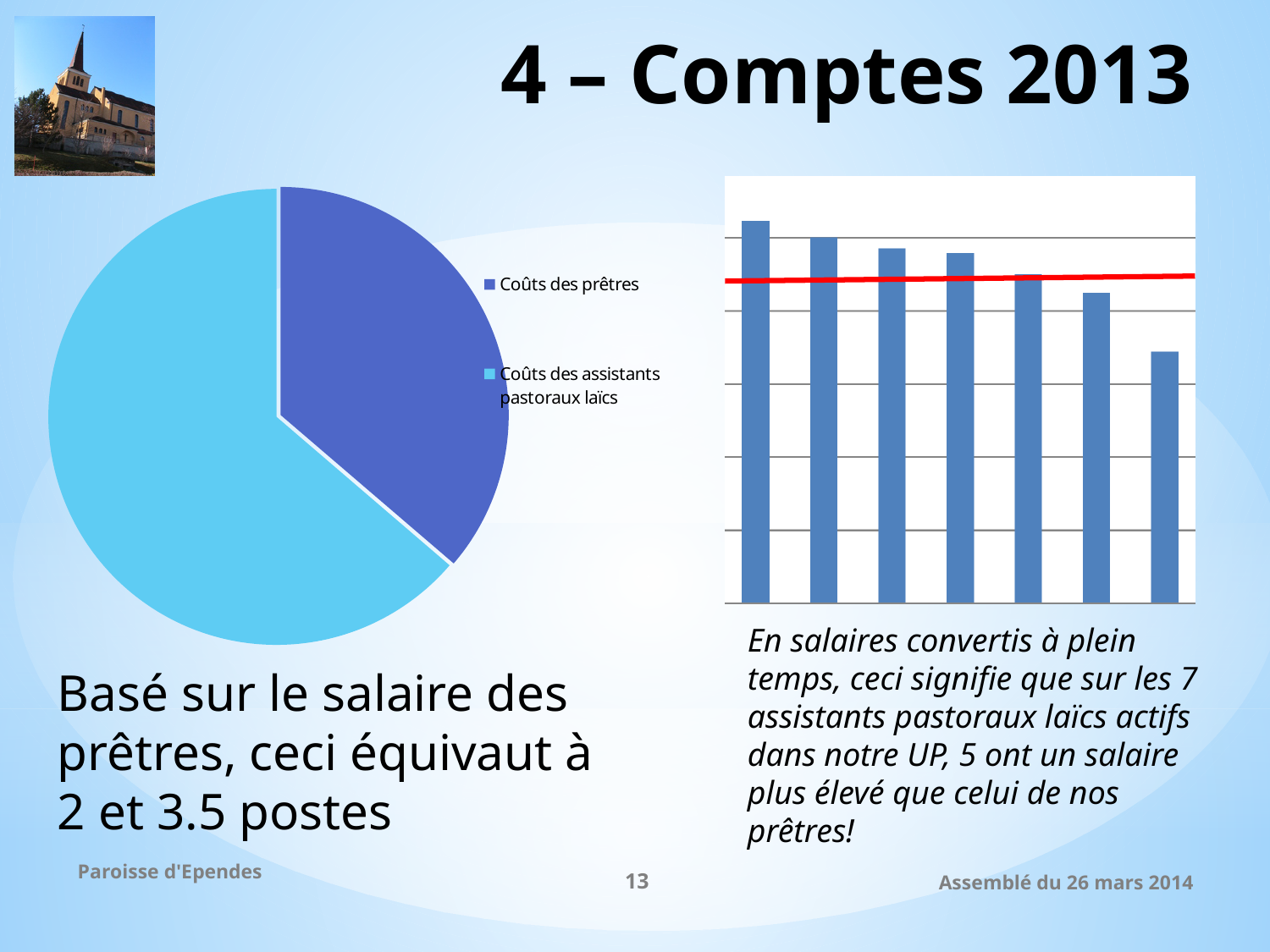
What kind of chart is the chart on the left of the slide? pie chart In the pie chart on the left, how many entries does the legend list? 2 In the bar chart on the right, which bar is the tallest? the first (leftmost) bar In the bar chart on the right, which bar is the shortest? the last (rightmost) bar In the pie chart on the left, which slice is larger: 'Coûts des prêtres' or 'Coûts des assistants pastoraux laïcs'? Coûts des assistants pastoraux laïcs In the bar chart on the right, do the bar values rise or fall from left to right? fall In the pie chart on the left, which category has the smallest slice? Coûts des prêtres What kind of chart is the chart on the right of the slide? bar chart In the bar chart on the right, how many bars rise above the red horizontal line? 5 In the pie chart on the left, what colour is the slice for 'Coûts des prêtres'? dark blue In the bar chart on the right, how many bars are plotted? 7 In the bar chart on the right, which is taller: the second bar or the sixth bar? the second bar